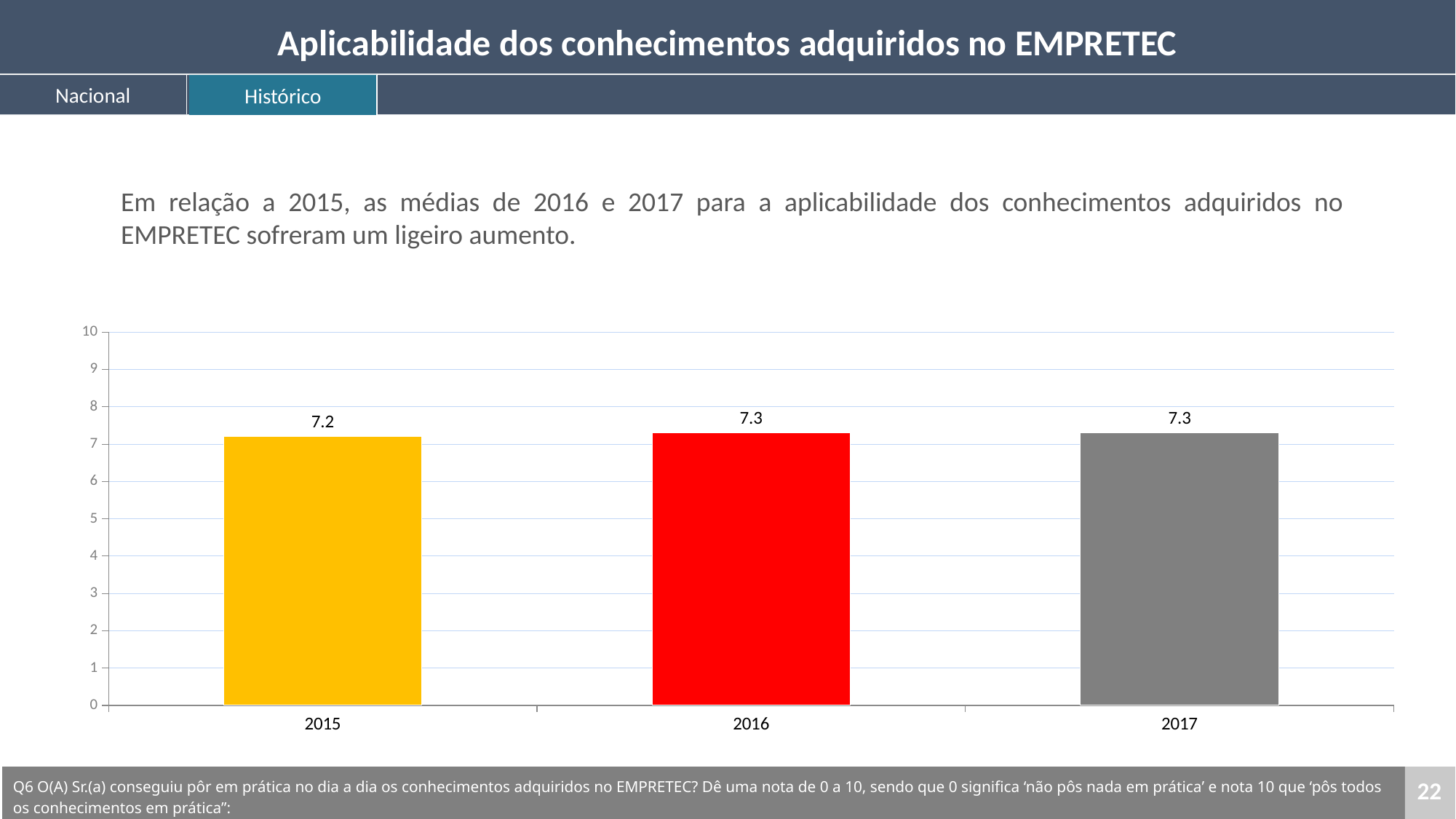
What colour is the bar for 2016? red Do the values rise or fall from 2015 to 2017? rise How many years are shown on the x axis? 3 What kind of chart is shown on the slide? bar chart What is the difference between the values for 2016 and 2015? 0.1 What is the value for 2017? 7.3 Is the value for 2015 greater or less than 8? less Which is larger, the value for 2015 or the value for 2017? 2017 Is the value for 2017 greater or less than 5? greater Which year has the lowest value? 2015 What is the value for 2016? 7.3 What is the value for 2015? 7.2